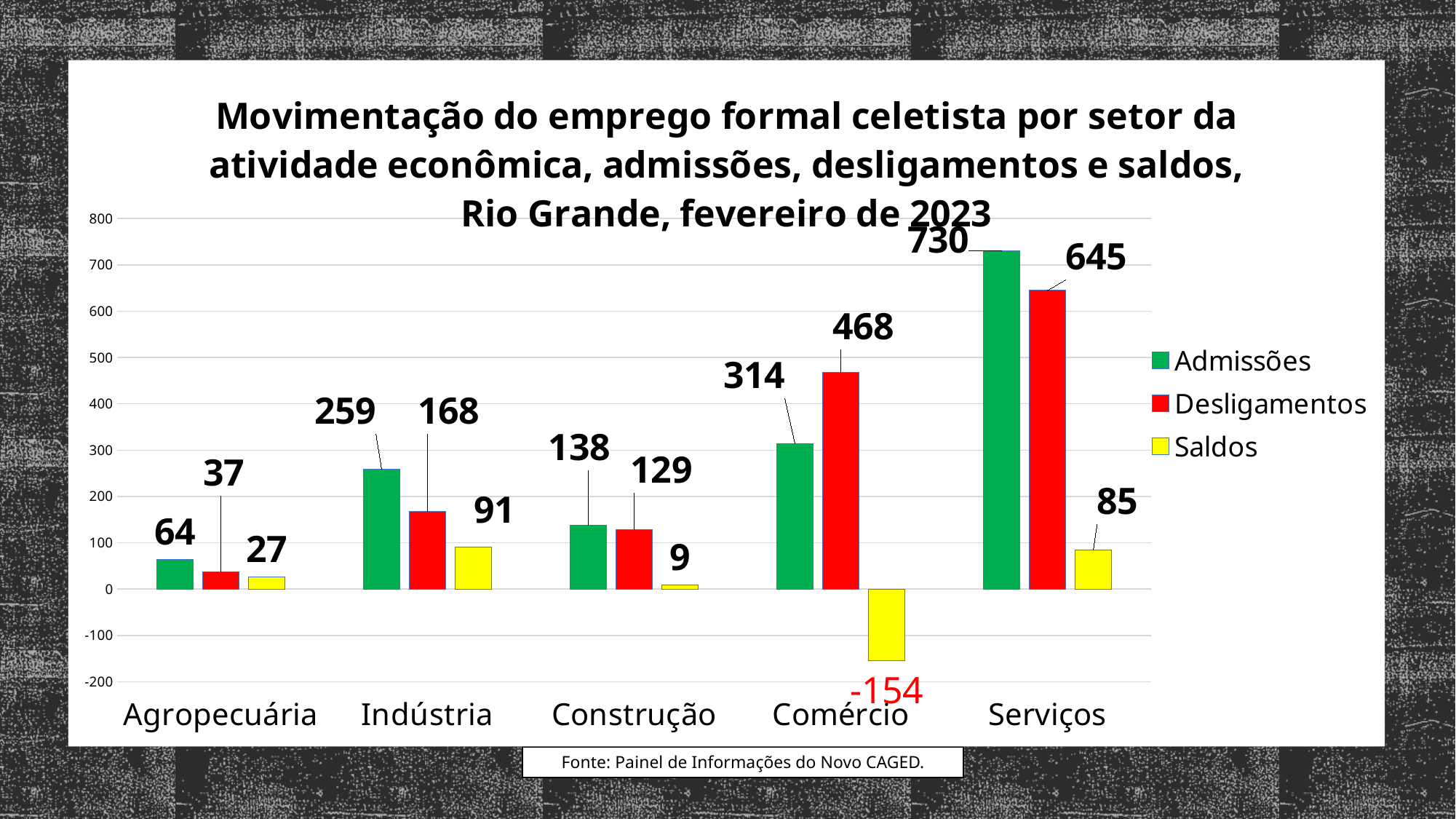
Which sector has the highest Admissões value? Serviços What colour are the Saldos bars? Yellow What is the difference between Admissões and Desligamentos for Indústria? 91 Which sector has the lowest Saldos value? Comércio What is the Admissões value for Serviços? 730 What is the Saldos value for Comércio? -154 What kind of chart is shown on the slide? Bar chart What is the Desligamentos value for Comércio? 468 How many sectors are shown on the x axis? 5 Which is larger for Comércio, Admissões or Desligamentos? Desligamentos How many series does the legend list? 3 What is the Saldos value for Construção? 9